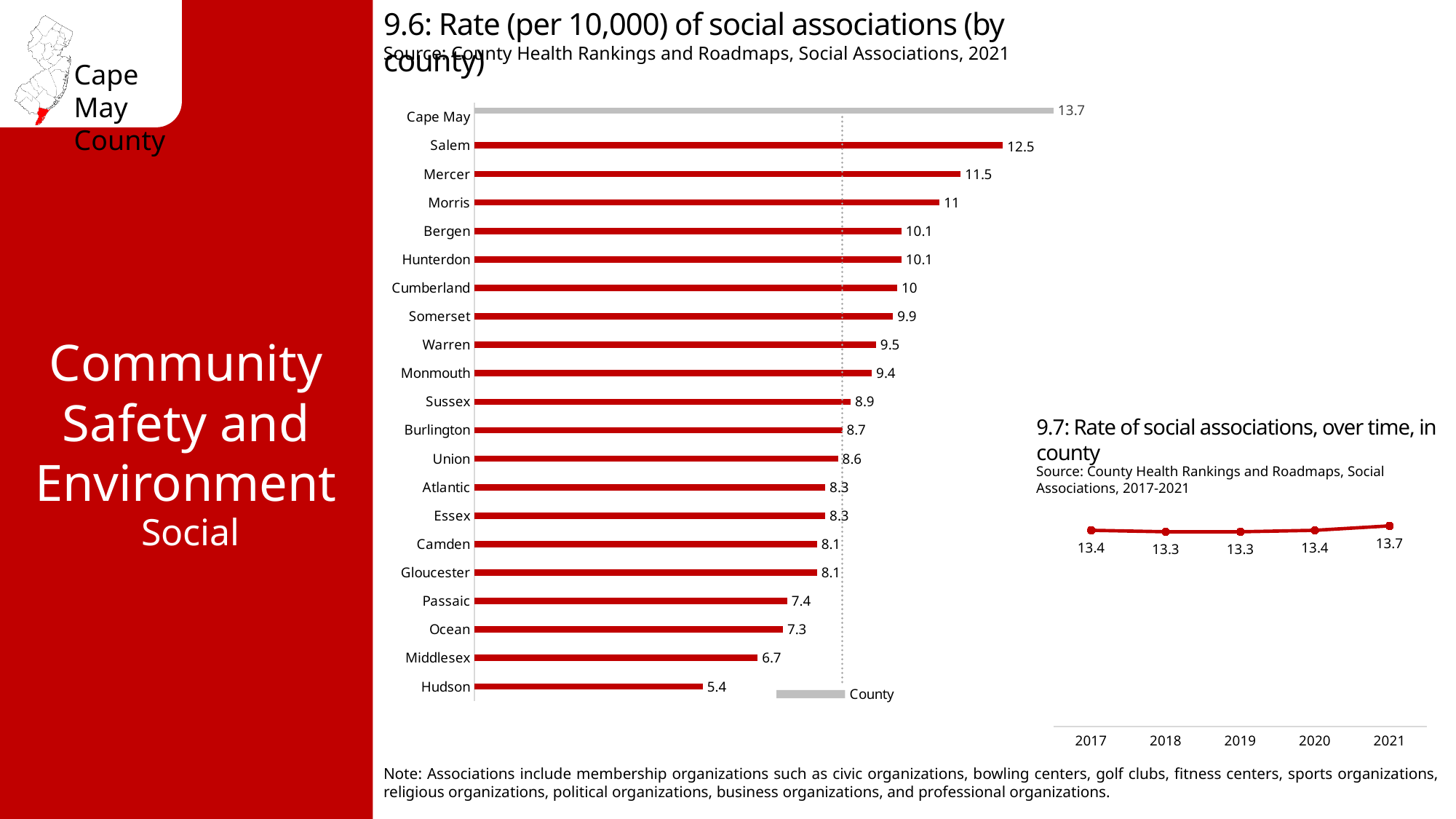
What kind of chart is chart 9.7 (rate of social associations over time)? Line chart In chart 9.6 (rate of social associations by county), what is the difference between the values for Cape May and Hudson? 8.3 In chart 9.6 (rate of social associations by county), how many counties are shown? 21 What kind of chart is chart 9.6 (rate of social associations by county)? Bar chart In chart 9.6 (rate of social associations by county), which county has the lowest rate? Hudson In chart 9.6 (rate of social associations by county), what is the value for Cape May? 13.7 In chart 9.7 (rate of social associations over time), what is the value for 2019? 13.3 In chart 9.6 (rate of social associations by county), which has a higher rate, Mercer or Morris? Mercer In chart 9.7 (rate of social associations over time), which year has the highest value? 2021 In chart 9.6 (rate of social associations by county), what is the value for Salem? 12.5 In chart 9.7 (rate of social associations over time), what is the difference between the 2021 and 2017 values? 0.3 In chart 9.6 (rate of social associations by county), which county has the highest rate? Cape May